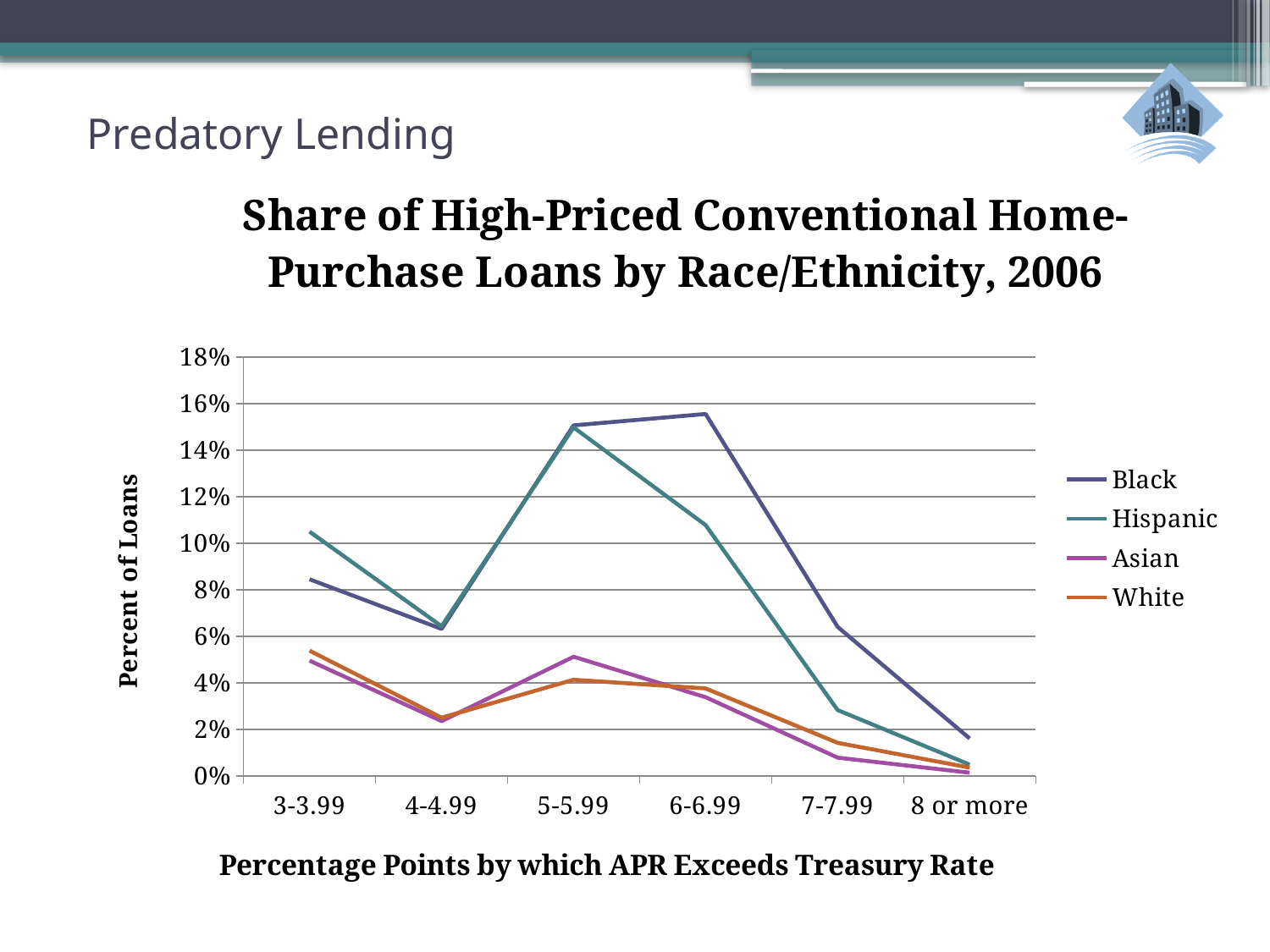
What kind of chart is shown on the slide? Line chart Does the Hispanic line rise or fall from 5-5.99 to 8 or more? Falls Is the value for Hispanic in the 7-7.99 category greater or less than 4%? less What is the label of the y axis? Percent of Loans Which series has the highest value in the 3-3.99 category? Hispanic Is the value for Black in the 6-6.99 category greater or less than 14%? greater How many categories are shown on the x axis? 6 In which category is the value for Black lowest? 8 or more Is the value for Asian in the 5-5.99 category greater or less than 4%? greater Which series has the highest value in the 6-6.99 category? Black In the 7-7.99 category, which is larger: the value for Black or the value for Hispanic? Black How many series does the legend list? 4